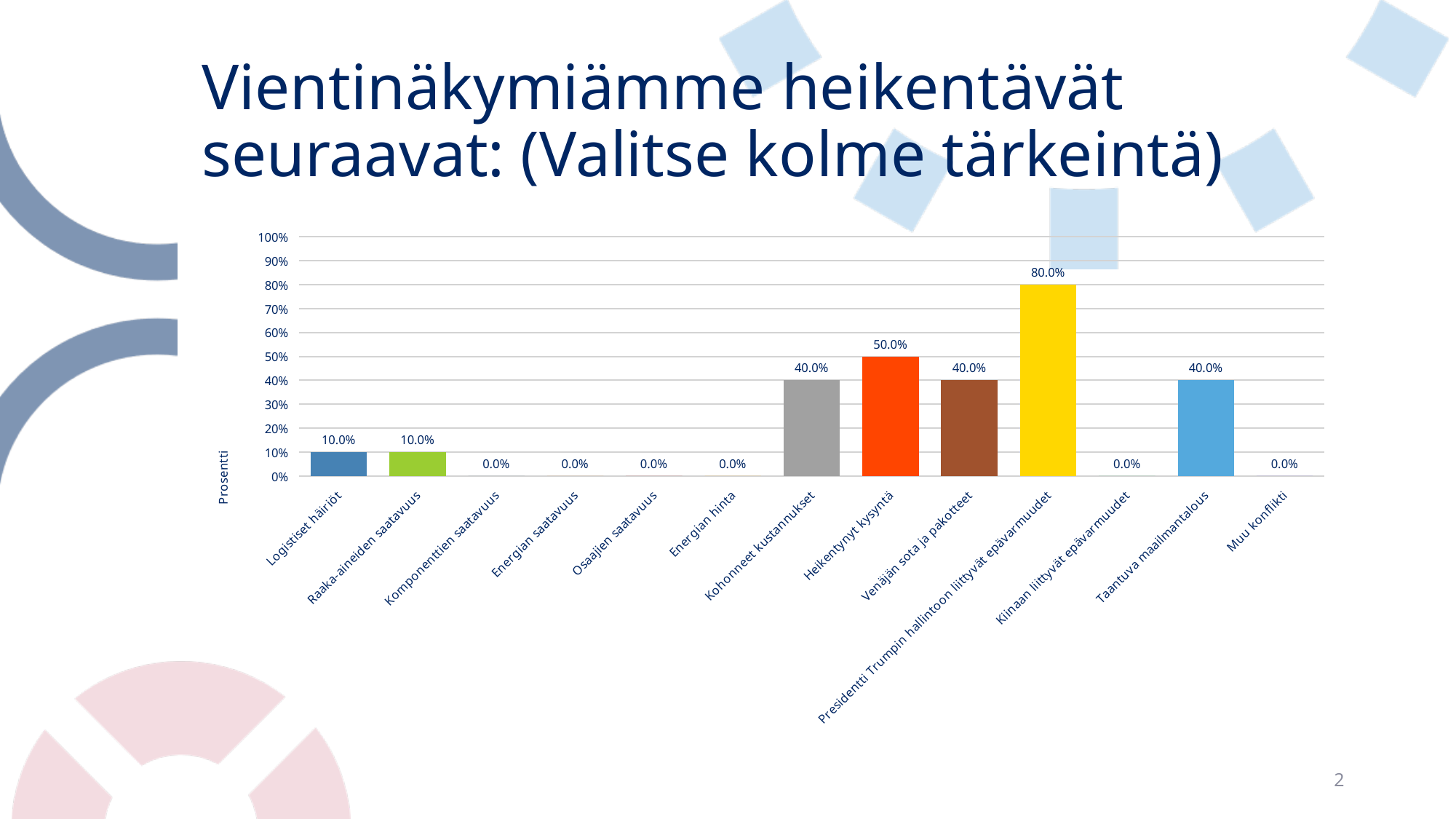
What is the label of the vertical axis? Prosentti Which category has the highest value? Presidentti Trumpin hallintoon liittyvät epävarmuudet Which is larger, the value for Heikentynyt kysyntä or the value for Venäjän sota ja pakotteet? Heikentynyt kysyntä What is the difference between the values for Presidentti Trumpin hallintoon liittyvät epävarmuudet and Heikentynyt kysyntä? 30.0% How many categories are shown on the x axis? 13 Is the value for Presidentti Trumpin hallintoon liittyvät epävarmuudet greater or less than 70%? greater What is the value for Heikentynyt kysyntä? 50.0% What is the difference between the values for Kohonneet kustannukset and Raaka-aineiden saatavuus? 30.0% What is the value for Presidentti Trumpin hallintoon liittyvät epävarmuudet? 80.0% What is the value for Logistiset häiriöt? 10.0% What kind of chart is shown on the slide? bar chart What is the value for Kiinaan liittyvät epävarmuudet? 0.0%